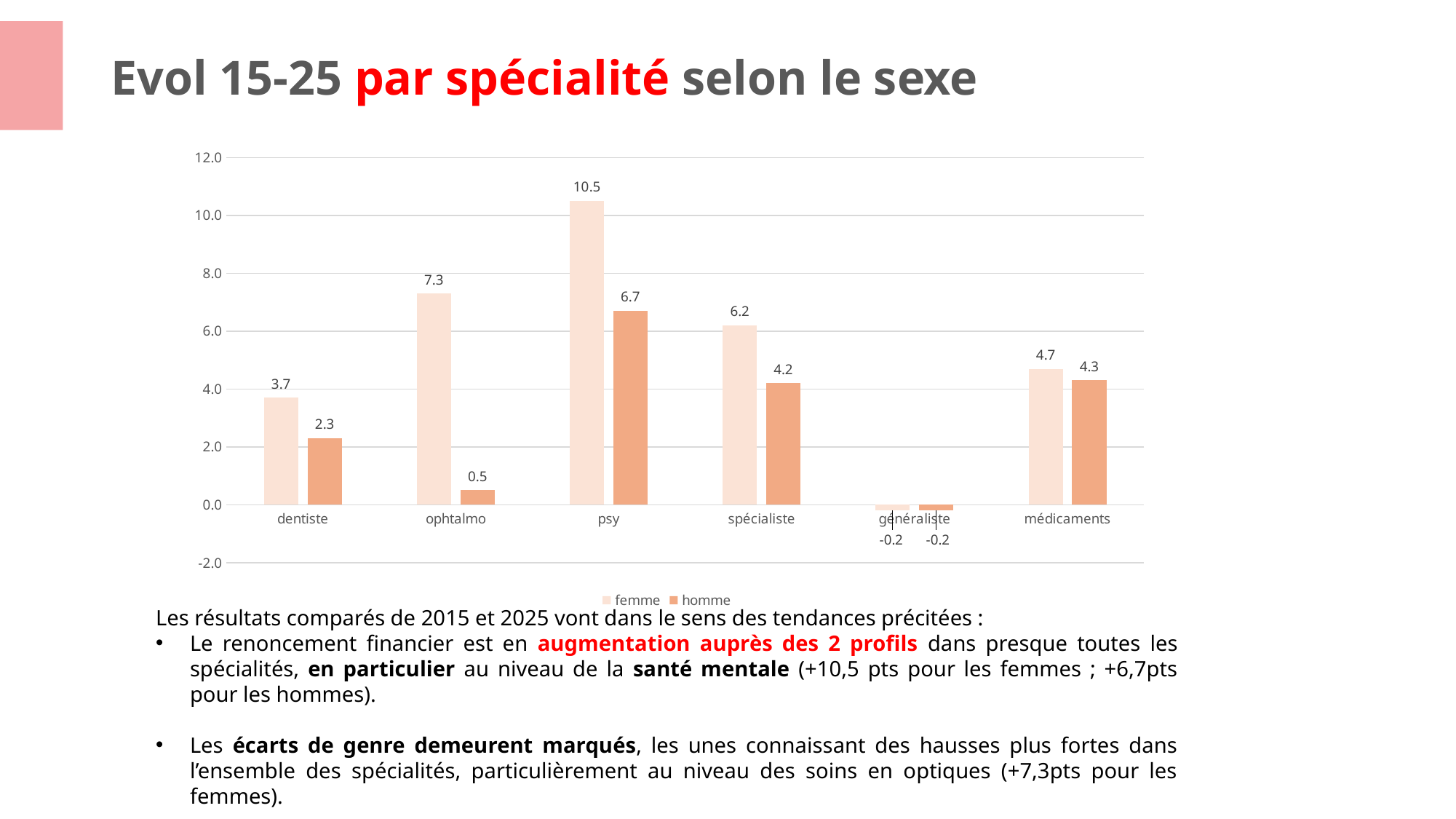
What is the value for femme in the médicaments category? 4.7 Which category has the lowest value for homme? généraliste What is the difference between the femme and homme values for psy? 3.8 How many series does the legend list? 2 Which is larger for spécialiste, the femme value or the homme value? femme How many categories are shown on the x axis? 6 What is the value for femme in the psy category? 10.5 What is the value for homme in the ophtalmo category? 0.5 What is the difference between the femme and homme values for dentiste? 1.4 Which category has the highest value for femme? psy What are the two series named in the legend? femme and homme What kind of chart is shown on the slide? bar chart